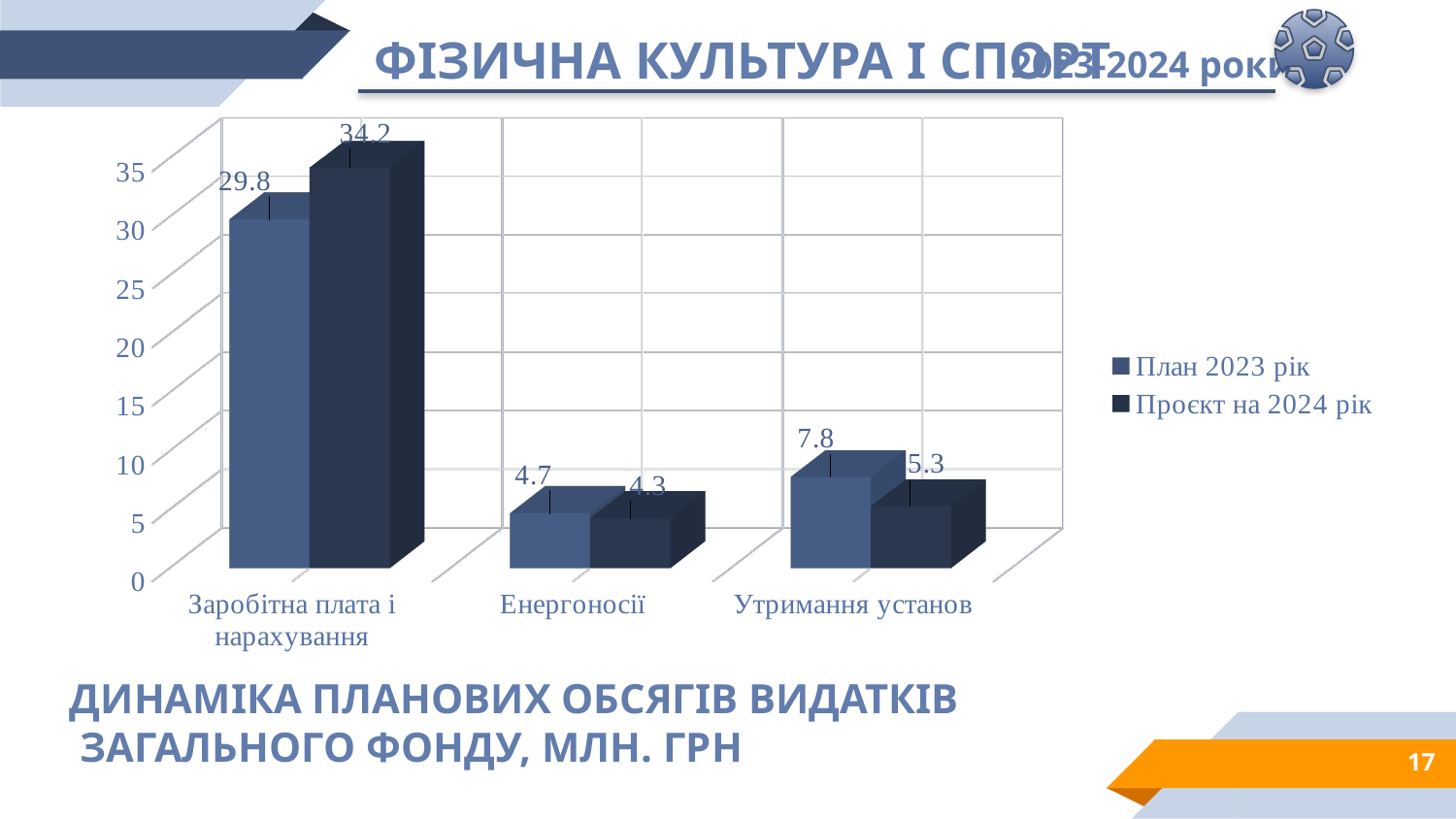
What kind of chart is shown on the slide? Bar chart Which category has the lowest value in the "План 2023 рік" series? Енергоносії Which category has the highest value in the "Проєкт на 2024 рік" series? Заробітна плата і нарахування What is the value for "Енергоносії" in the "План 2023 рік" series? 4.7 How many series does the legend list? 2 What is the value for "Утримання установ" in the "Проєкт на 2024 рік" series? 5.3 Is the "План 2023 рік" value for "Утримання установ" greater or less than 10? less What is the value for "Заробітна плата і нарахування" in the "План 2023 рік" series? 29.8 What is the value for "Заробітна плата і нарахування" in the "Проєкт на 2024 рік" series? 34.2 How many categories are shown on the x axis? 3 What is the difference between the "Проєкт на 2024 рік" and "План 2023 рік" values for "Заробітна плата і нарахування"? 4.4 For "Утримання установ", which is larger: the "План 2023 рік" value or the "Проєкт на 2024 рік" value? План 2023 рік